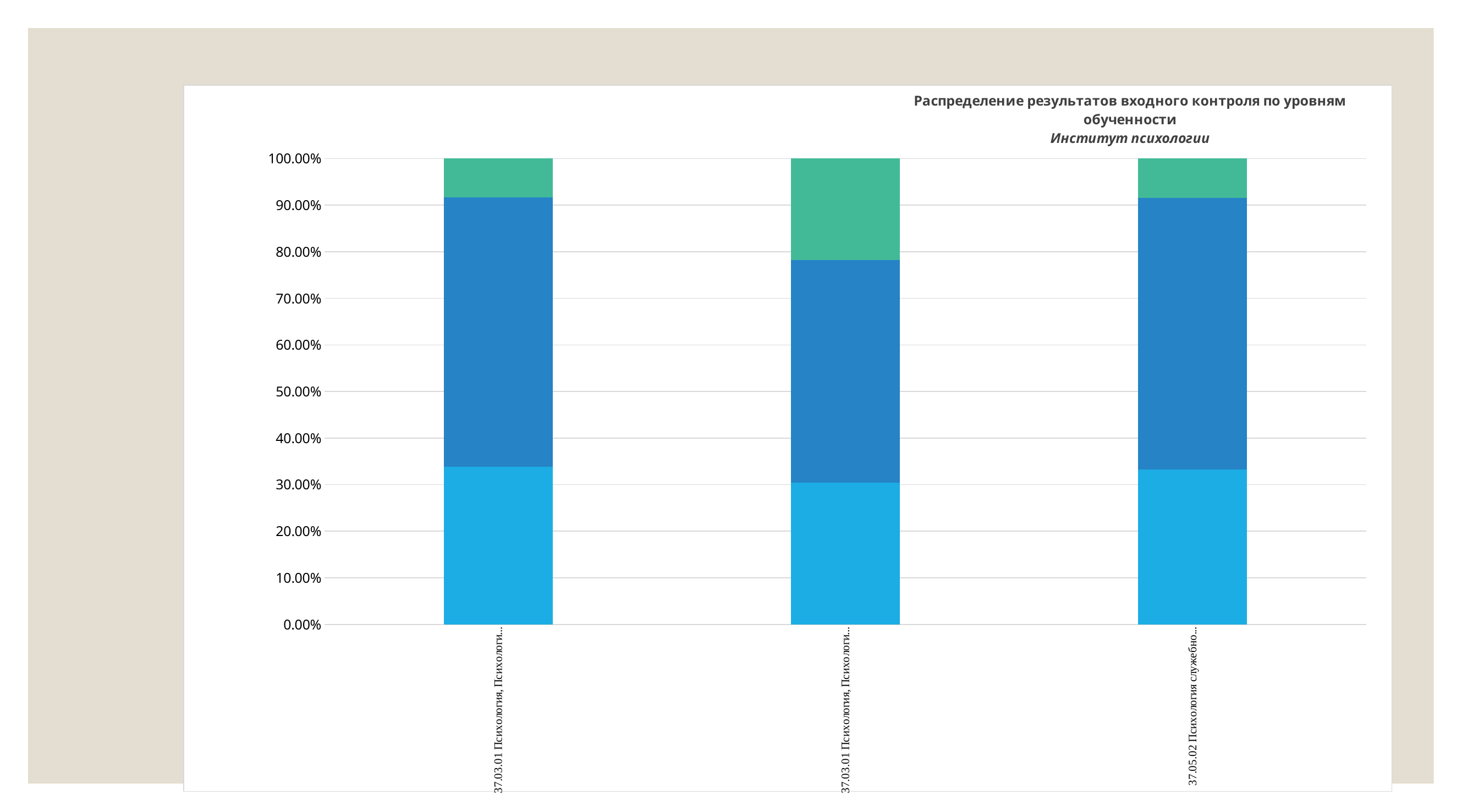
Is the top of the dark blue (middle) segment in the leftmost bar greater or less than 90%? greater What is the title of the chart? Распределение результатов входного контроля по уровням обученности Which bar has the largest green (top) segment: the leftmost, middle, or rightmost? middle What is the total height of the leftmost stacked bar? 100.00% Is the top of the light blue (bottom) segment in the leftmost bar greater or less than 30%? greater Is the dark blue (middle) segment larger in the leftmost bar or in the middle bar? leftmost bar Which institute is named in the chart's subtitle? Институт психологии What kind of chart is shown on the slide? Stacked bar chart How many bars are plotted in the chart? 3 How many coloured segments make up each stacked bar? 3 Is the top of the dark blue (middle) segment in the middle bar greater or less than 80%? less